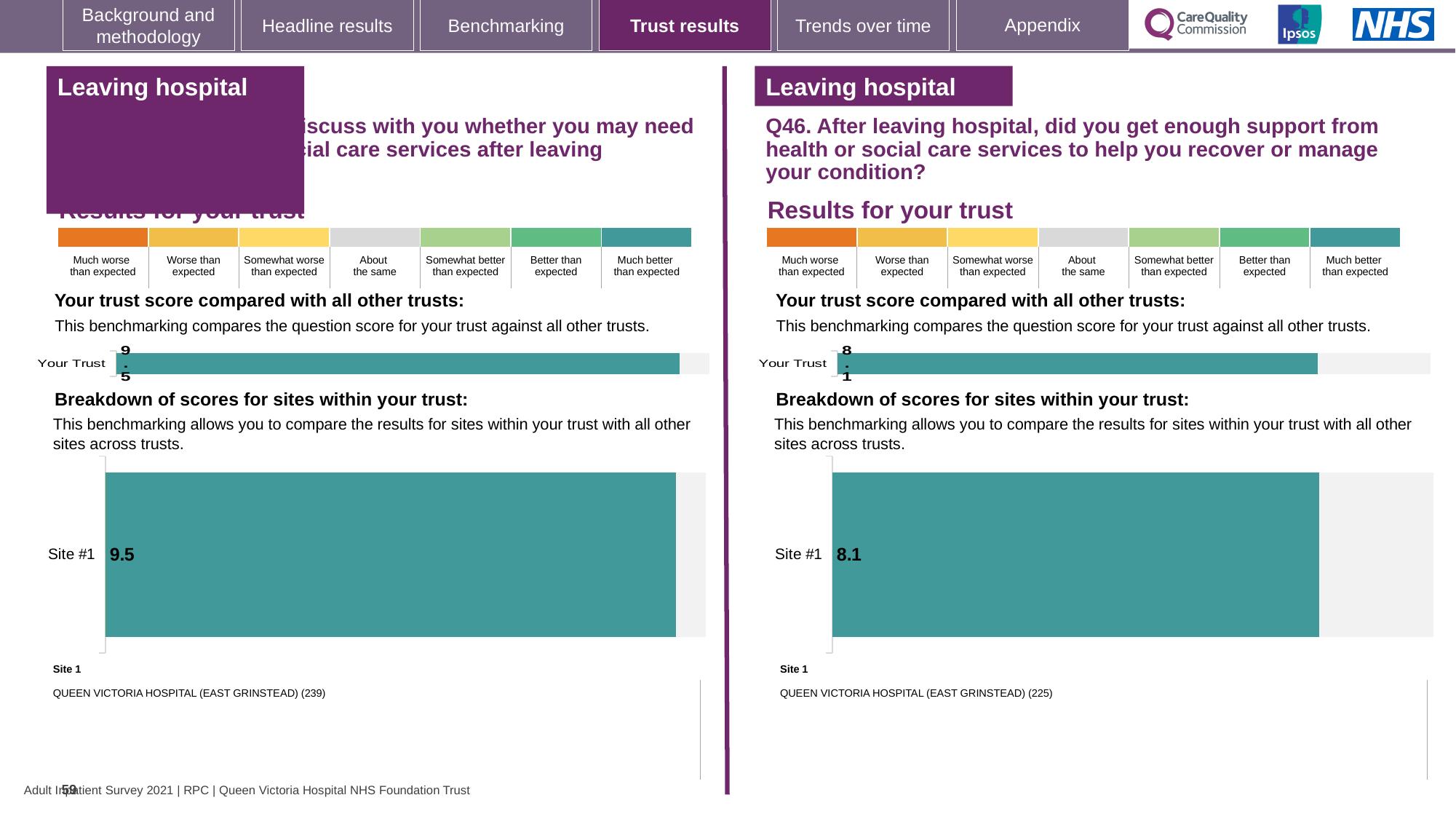
What colour is the Your Trust bar in the right-hand 'Your trust score compared with all other trusts' chart (Q46)? Teal Which site is listed as Site 1 beneath the right-hand breakdown chart (Q46)? QUEEN VICTORIA HOSPITAL (EAST GRINSTEAD) (225) In the left-hand 'Breakdown of scores for sites within your trust' chart, what is the score for Site #1? 9.5 What type of chart is used to show the Site #1 score in the right-hand breakdown chart (Q46)? Bar chart What is the difference between the Site #1 score on the left-hand breakdown chart and the Site #1 score on the right-hand breakdown chart (Q46)? 1.4 On the left-hand side of the slide, what is the score shown for Your Trust in the 'Your trust score compared with all other trusts' chart? 9.5 Which is larger: the Your Trust score on the left-hand chart or the Your Trust score on the right-hand chart (Q46)? The left-hand chart (9.5) On the right-hand side of the slide (Q46), what is the score shown for Your Trust in the 'Your trust score compared with all other trusts' chart? 8.1 In the right-hand 'Breakdown of scores for sites within your trust' chart (Q46), what is the score for Site #1? 8.1 How many categories does the colour scale above the left-hand 'Results for your trust' section contain, from 'Much worse than expected' to 'Much better than expected'? 7 How many sites are shown in the right-hand 'Breakdown of scores for sites within your trust' chart (Q46)? 1 How many sites are shown in the left-hand 'Breakdown of scores for sites within your trust' chart? 1